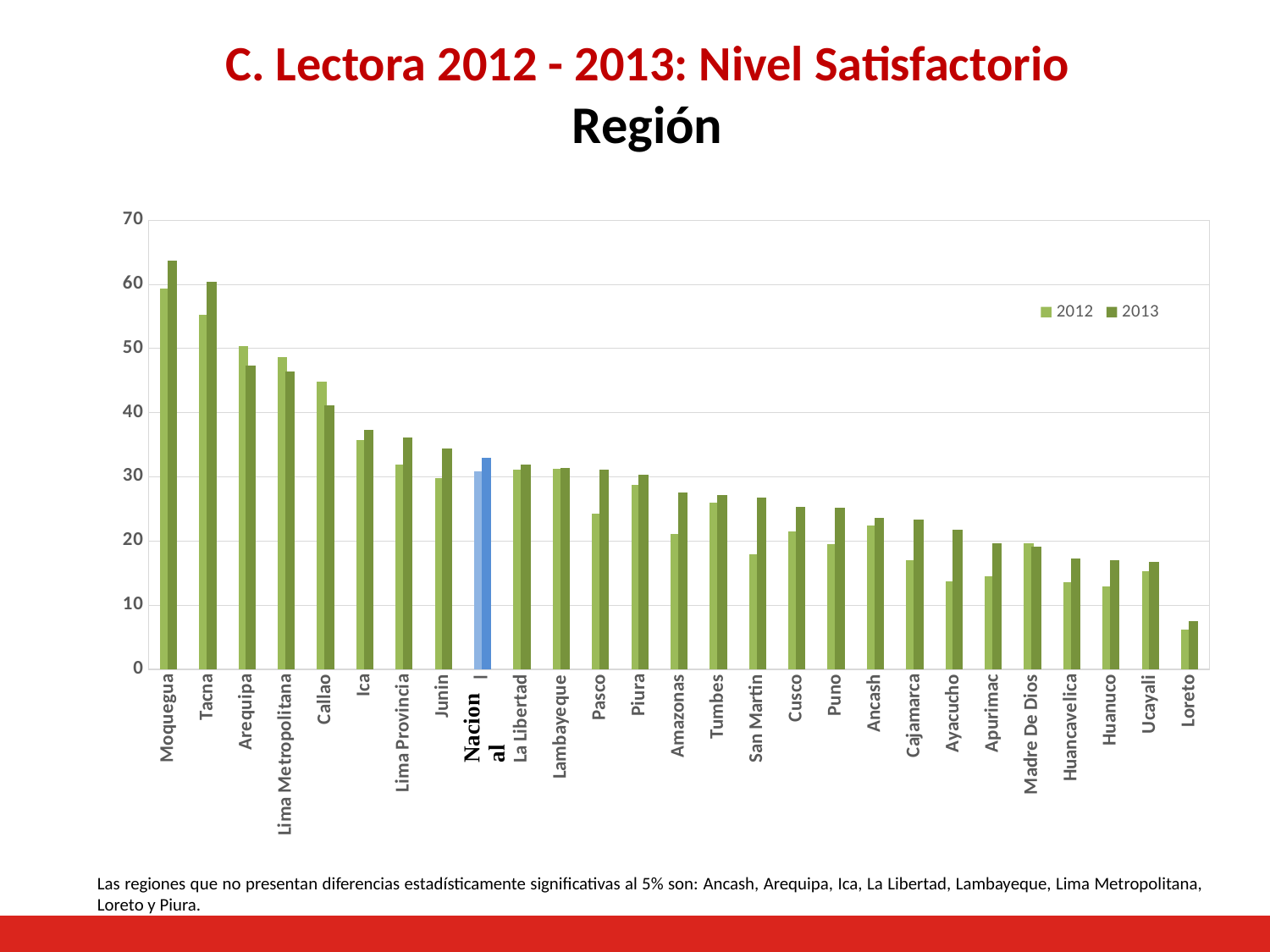
For Pasco, which is larger: the 2012 value or the 2013 value? 2013 Is the 2013 value for Loreto greater or less than 10? less Is the 2012 value for Moquegua greater or less than 50? greater Which category has the lowest 2012 value? Loreto Do the values generally rise or fall moving from left to right along the x axis? fall How many series does the legend list? 2 For Arequipa, which is larger: the 2012 value or the 2013 value? 2012 Is the 2013 value for Ica greater or less than 30? greater How many categories are shown along the x axis? 27 What kind of chart is shown on the slide? bar chart Which category has the highest 2013 value? Moquegua